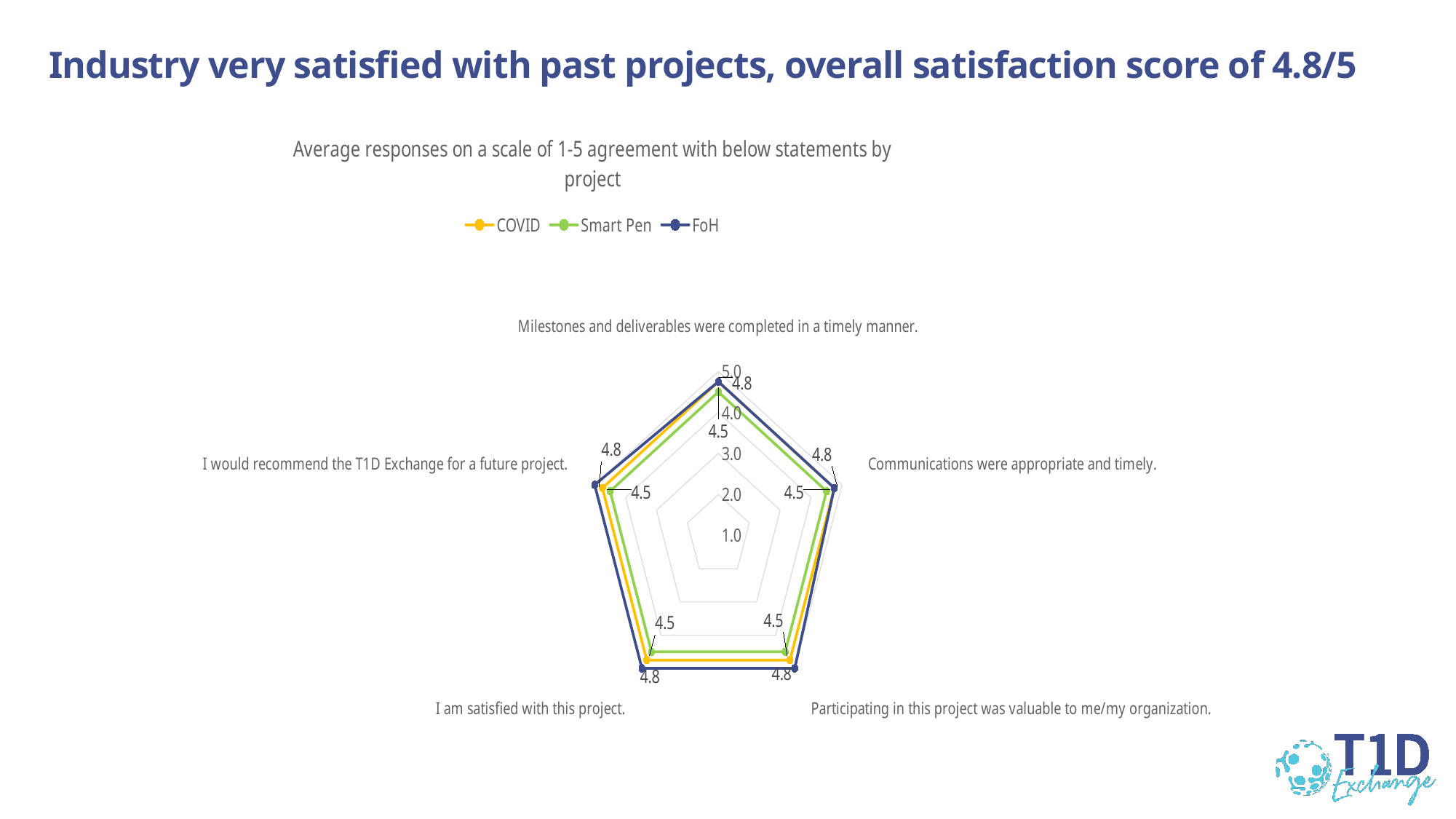
What is the highest value labelled on the chart? 5.0 Which is larger for 'Milestones and deliverables were completed in a timely manner.': FoH or Smart Pen? FoH Is the Smart Pen value for 'I am satisfied with this project.' greater or less than 4.0? greater Which series are listed in the legend? COVID, Smart Pen, FoH What kind of chart is shown on the slide? radar chart How many statements (axes) are plotted on the radar chart? 5 What is the title of the chart? Average responses on a scale of 1-5 agreement with below statements by project How many series does the legend list? 3 What is the maximum value on the radar chart's scale? 5.0 What is the lowest data value labelled on the chart? 4.5